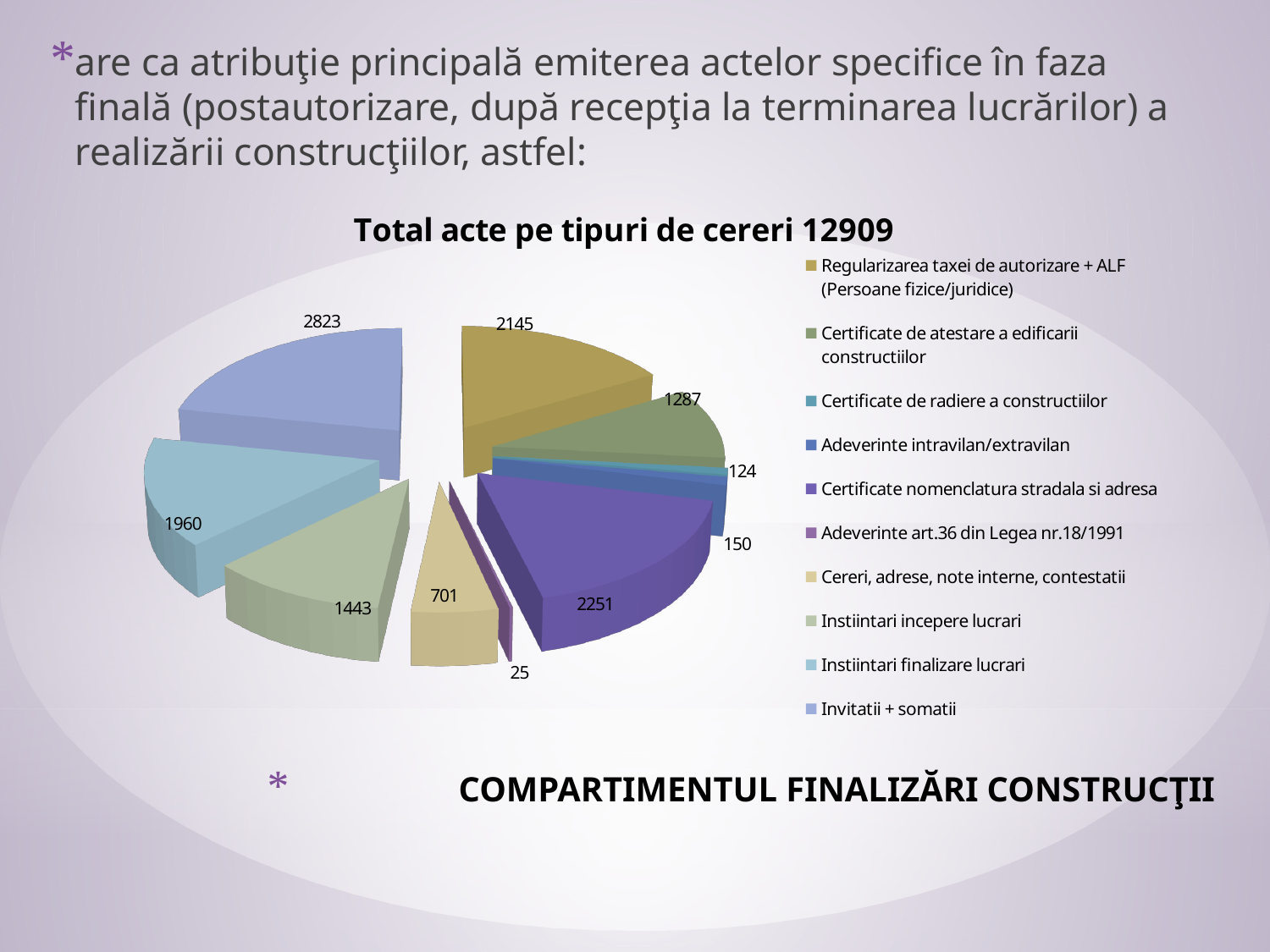
What is the title of the chart? Total acte pe tipuri de cereri 12909 Which category has the smallest slice of the pie? Adeverinte art.36 din Legea nr.18/1991 Which category has the largest slice of the pie? Invitatii + somatii What is the difference between the values for "Invitatii + somatii" and "Certificate nomenclatura stradala si adresa"? 572 What is the value for "Certificate de radiere a constructiilor"? 124 What is the value for "Instiintari finalizare lucrari"? 1960 How many categories does the pie chart's legend list? 10 What is the value for "Certificate nomenclatura stradala si adresa"? 2251 Which is larger, the value for "Instiintari incepere lucrari" or the value for "Certificate de atestare a edificarii constructiilor"? Instiintari incepere lucrari What is the value for "Invitatii + somatii"? 2823 What is the value for "Cereri, adrese, note interne, contestatii"? 701 What type of chart is shown on the slide? Pie chart